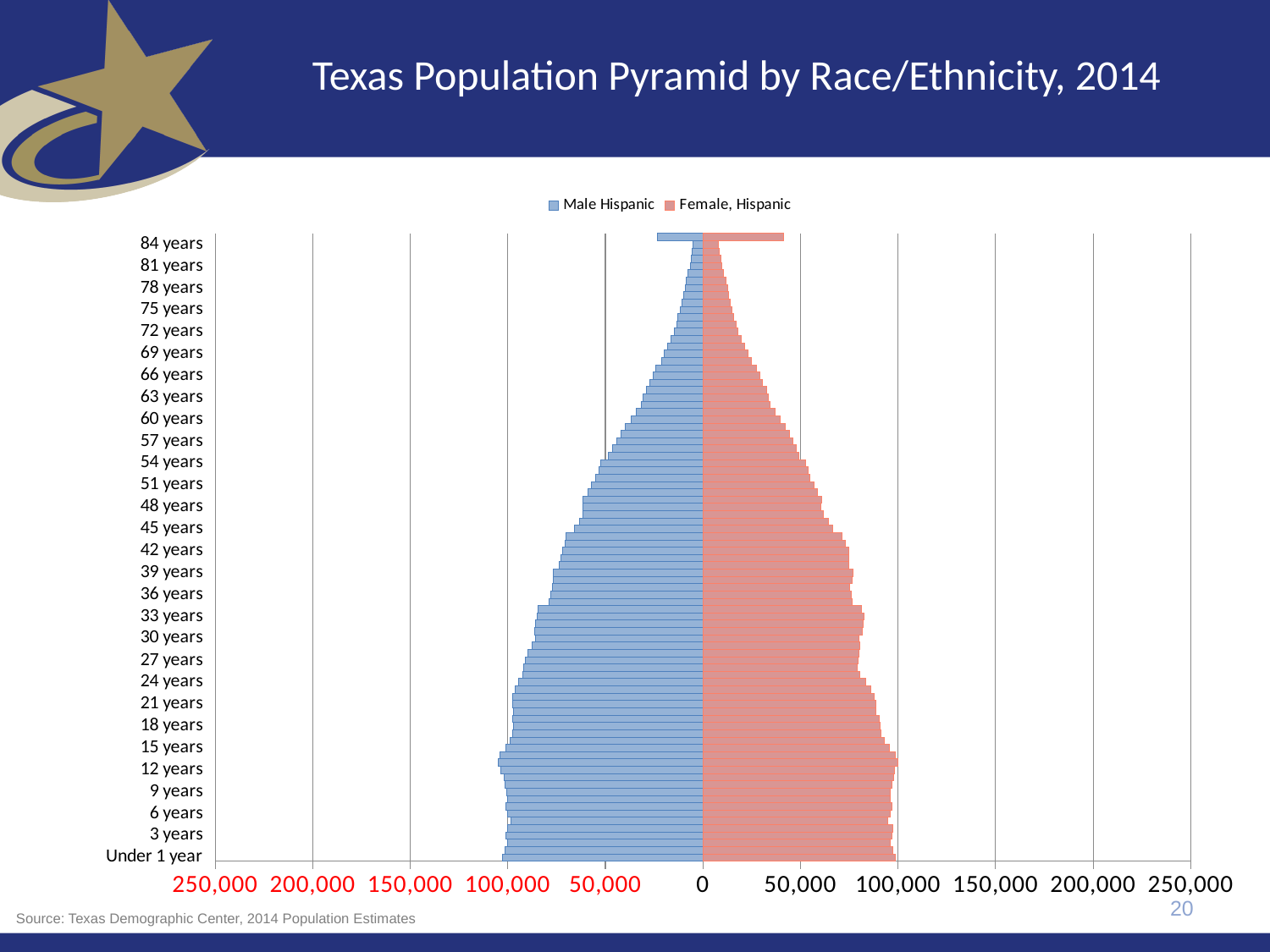
What kind of chart is shown on the slide? Bar chart (population pyramid) Which is larger for Male Hispanic: the value at 12 years or the value at 60 years? 12 years At 84 years, which is larger: the Male Hispanic value or the Female, Hispanic value? Female, Hispanic What is the title of the chart? Texas Population Pyramid by Race/Ethnicity, 2014 Is the Female, Hispanic value for 84 years greater or less than 50,000? less What are the two series named in the legend? Male Hispanic and Female, Hispanic Is the Male Hispanic value for 30 years greater or less than 50,000? greater How many series does the legend list? 2 Is the Male Hispanic value for 84 years greater or less than 50,000? less Moving from the youngest ages at the bottom to the oldest ages at the top, do the Female, Hispanic values generally rise or fall? fall